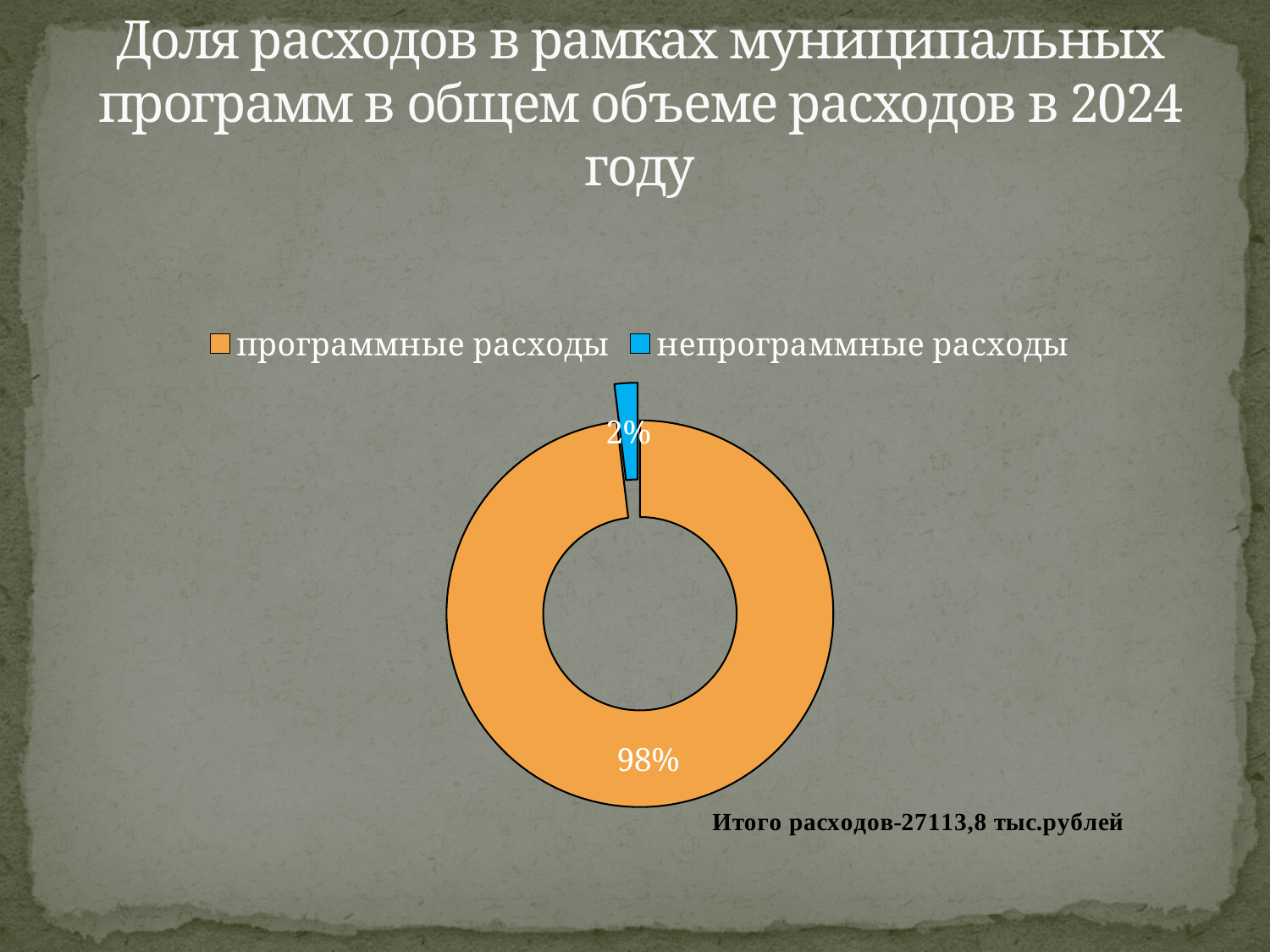
Which category has the largest share? программные расходы What share of the chart does 'непрограммные расходы' represent? 2% What is the difference in percentage points between 'программные расходы' and 'непрограммные расходы'? 96 Which category has the smallest share? непрограммные расходы How many entries does the legend list? 2 How many categories does the chart show? 2 What total expenditure is stated on the slide? 27113,8 тыс.рублей Which is larger: 'программные расходы' or 'непрограммные расходы'? программные расходы What share of the chart does 'программные расходы' represent? 98% What kind of chart is shown on the slide? doughnut (pie) chart What colour represents 'непрограммные расходы'? blue